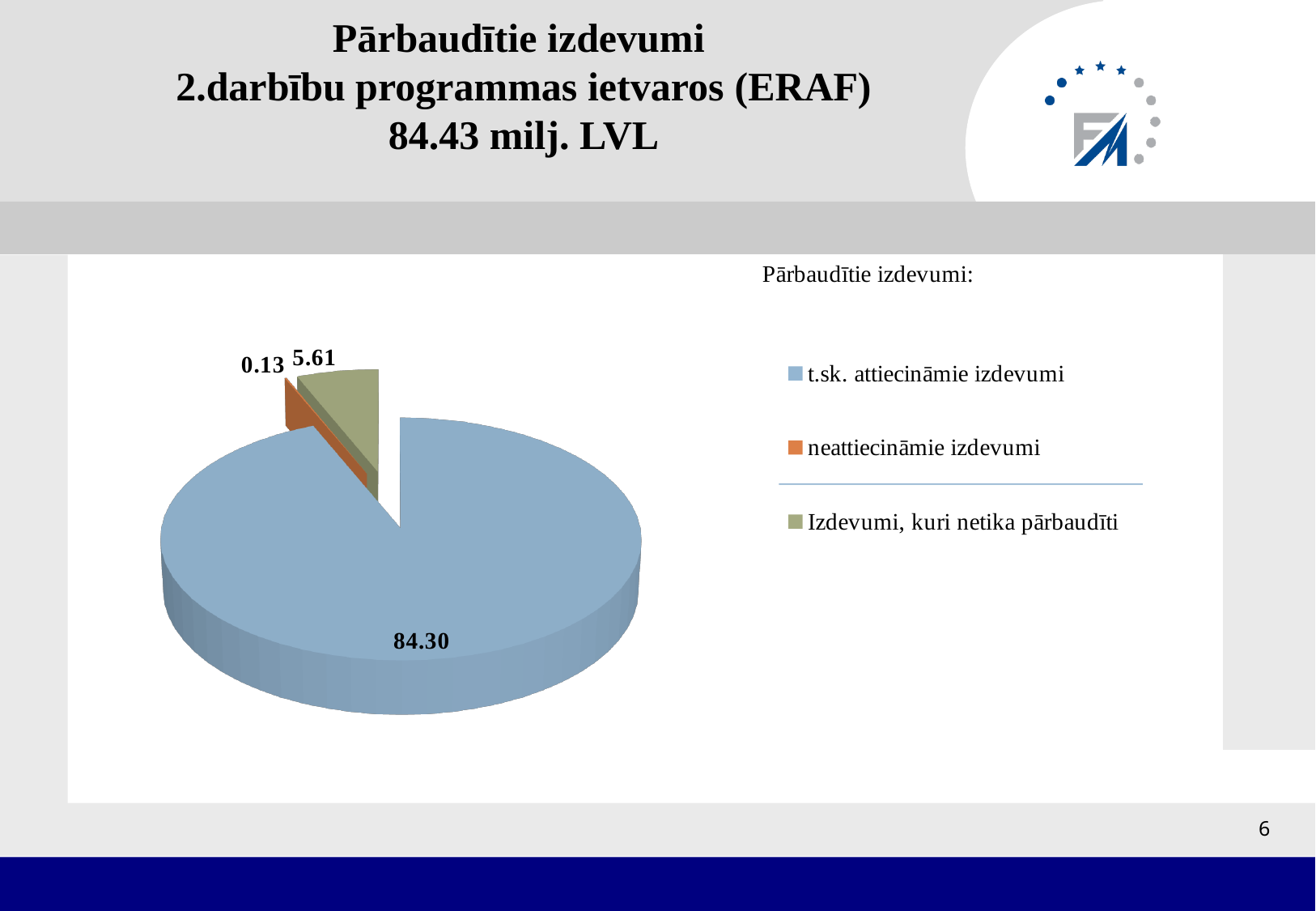
How many slices does the pie chart have? 3 Which category has the largest slice of the pie? t.sk. attiecināmie izdevumi Which is larger: the value for Izdevumi, kuri netika pārbaudīti or the value for neattiecināmie izdevumi? Izdevumi, kuri netika pārbaudīti What is the difference between the values for t.sk. attiecināmie izdevumi and Izdevumi, kuri netika pārbaudīti? 78.69 What colour is the slice for neattiecināmie izdevumi? orange Which category has the smallest slice of the pie? neattiecināmie izdevumi What is the value for Izdevumi, kuri netika pārbaudīti? 5.61 How many entries does the legend list? 3 What type of chart is shown on the slide? pie chart What is the difference between the values for Izdevumi, kuri netika pārbaudīti and neattiecināmie izdevumi? 5.48 What is the value for neattiecināmie izdevumi? 0.13 What is the value for t.sk. attiecināmie izdevumi? 84.30